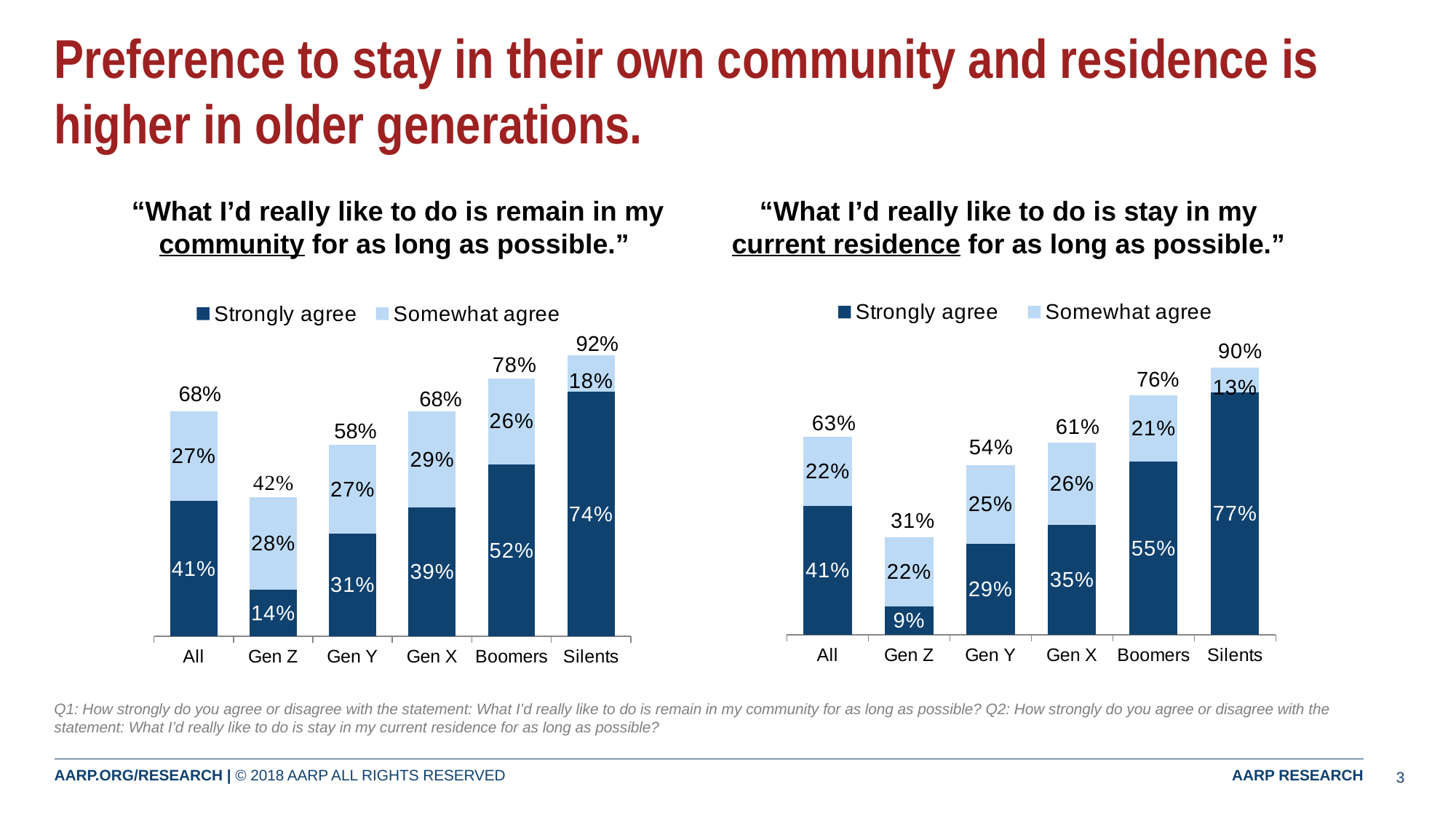
In the left chart (remain in my community), what is the Strongly agree value for Gen Z? 14% In the right chart (stay in my current residence), which generation has the lowest Strongly agree value? Gen Z How many generation categories are shown on the x axis of the right chart (stay in my current residence)? 6 How many series does the legend of the left chart (remain in my community) list? 2 In the left chart (remain in my community), which is larger: the Strongly agree value for Gen X or for Gen Y? Gen X What kind of chart is the right chart (stay in my current residence)? Stacked bar chart In the left chart (remain in my community), what is the total shown above the All bar? 68% In the right chart (stay in my current residence), do the total values rise or fall from Gen Z to Silents? Rise In the left chart (remain in my community), which generation has the highest total bar? Silents In the right chart (stay in my current residence), what is the Somewhat agree value for Boomers? 21% In the right chart (stay in my current residence), what is the difference between the Strongly agree values for Silents and Gen Z? 68% In the left chart (remain in my community), what is the total shown above the Boomers bar? 78%